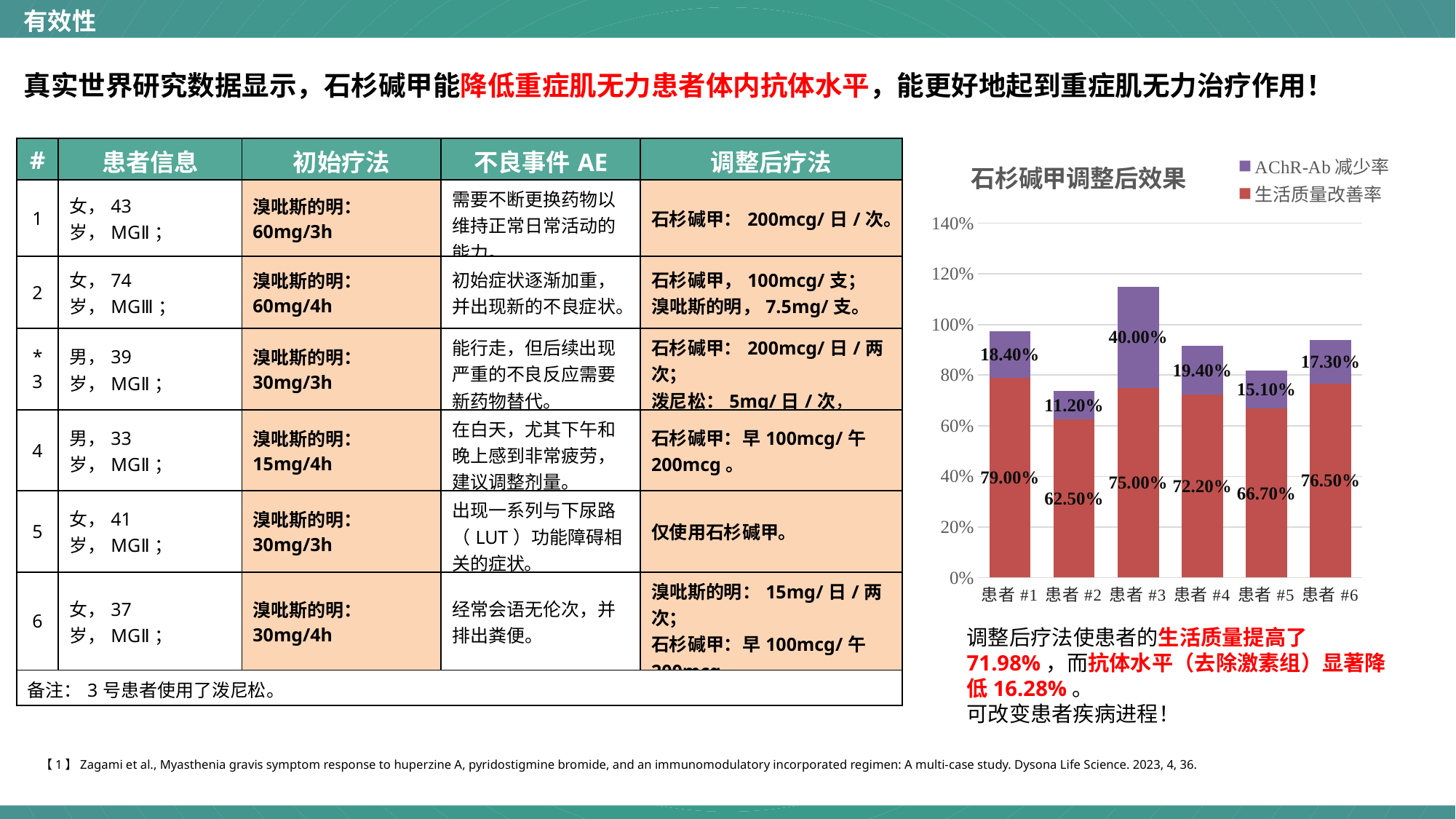
What is the total height of the stacked bar for 患者 #3? 115.00% Which patient has the lowest 生活质量改善率? 患者 #2 What type of chart is shown on the slide? Stacked bar chart What is the total height of the stacked bar for 患者 #2? 73.70% What is the AChR-Ab 减少率 value for 患者 #3? 40.00% How many series does the chart legend list? 2 What is the 生活质量改善率 value for 患者 #1? 79.00% What is the difference between the 生活质量改善率 of 患者 #1 and 患者 #2? 16.50% How many patients are shown on the x axis of the chart? 6 Which patient has the highest AChR-Ab 减少率? 患者 #3 What is the AChR-Ab 减少率 value for 患者 #5? 15.10% Which is larger, the 生活质量改善率 of 患者 #4 or of 患者 #6? 患者 #6